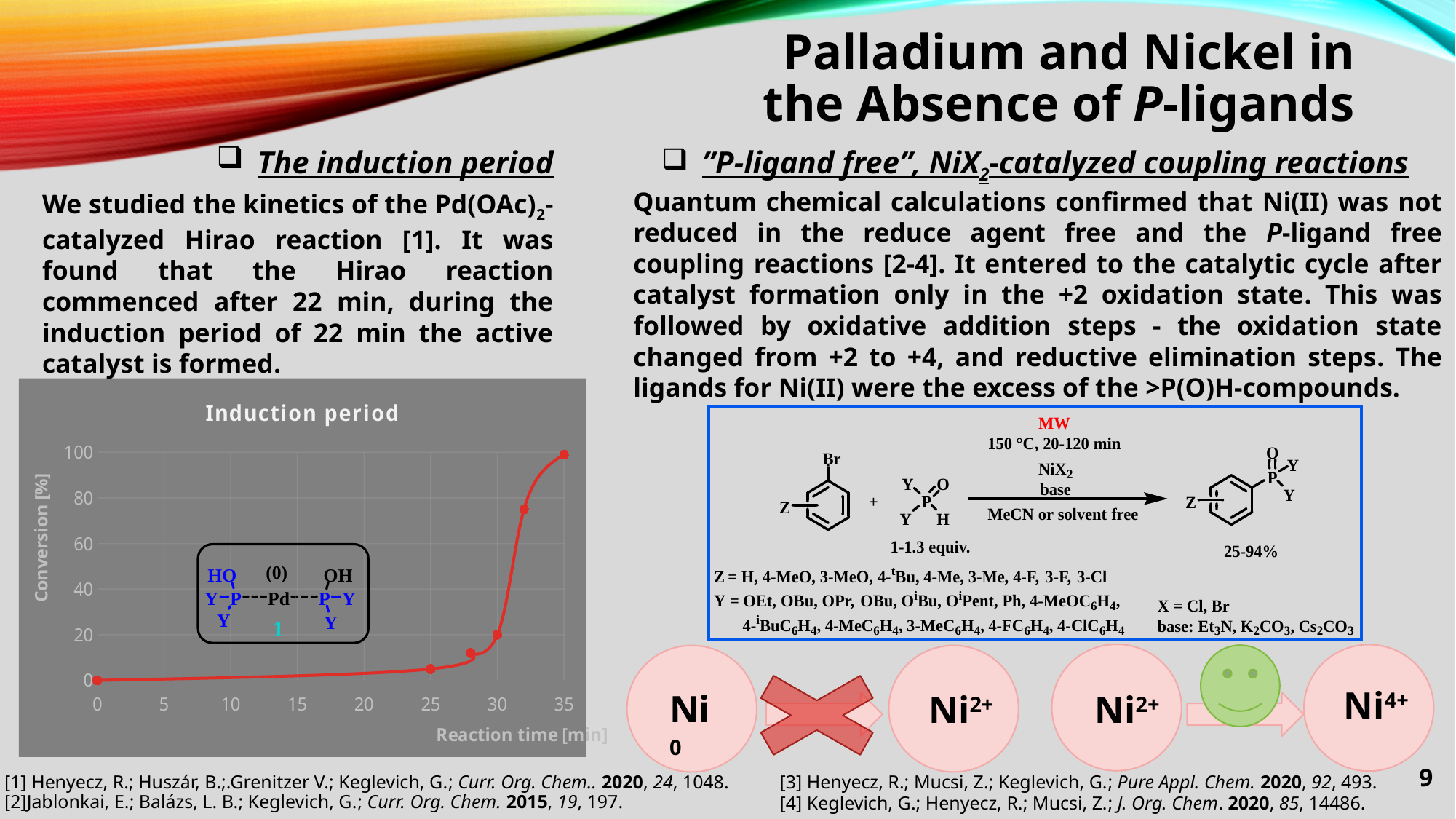
In the "Induction period" chart, which reaction time has the highest conversion, 32 min or 35 min? 35 min Does the conversion in the "Induction period" chart rise or fall as reaction time increases? rise In the "Induction period" chart, is the conversion at 35 min greater or less than 80? greater How many data points are plotted on the "Induction period" chart? 6 In the "Induction period" chart, is the conversion at 32 min greater or less than 60? greater What kind of chart is the "Induction period" chart? line chart In the "Induction period" chart, at which plotted reaction time is the conversion lowest? 0 In the "Induction period" chart, is the conversion at 28 min greater or less than 20? less What is the label of the x axis of the "Induction period" chart? Reaction time [min] What is the title of the chart on the slide? Induction period